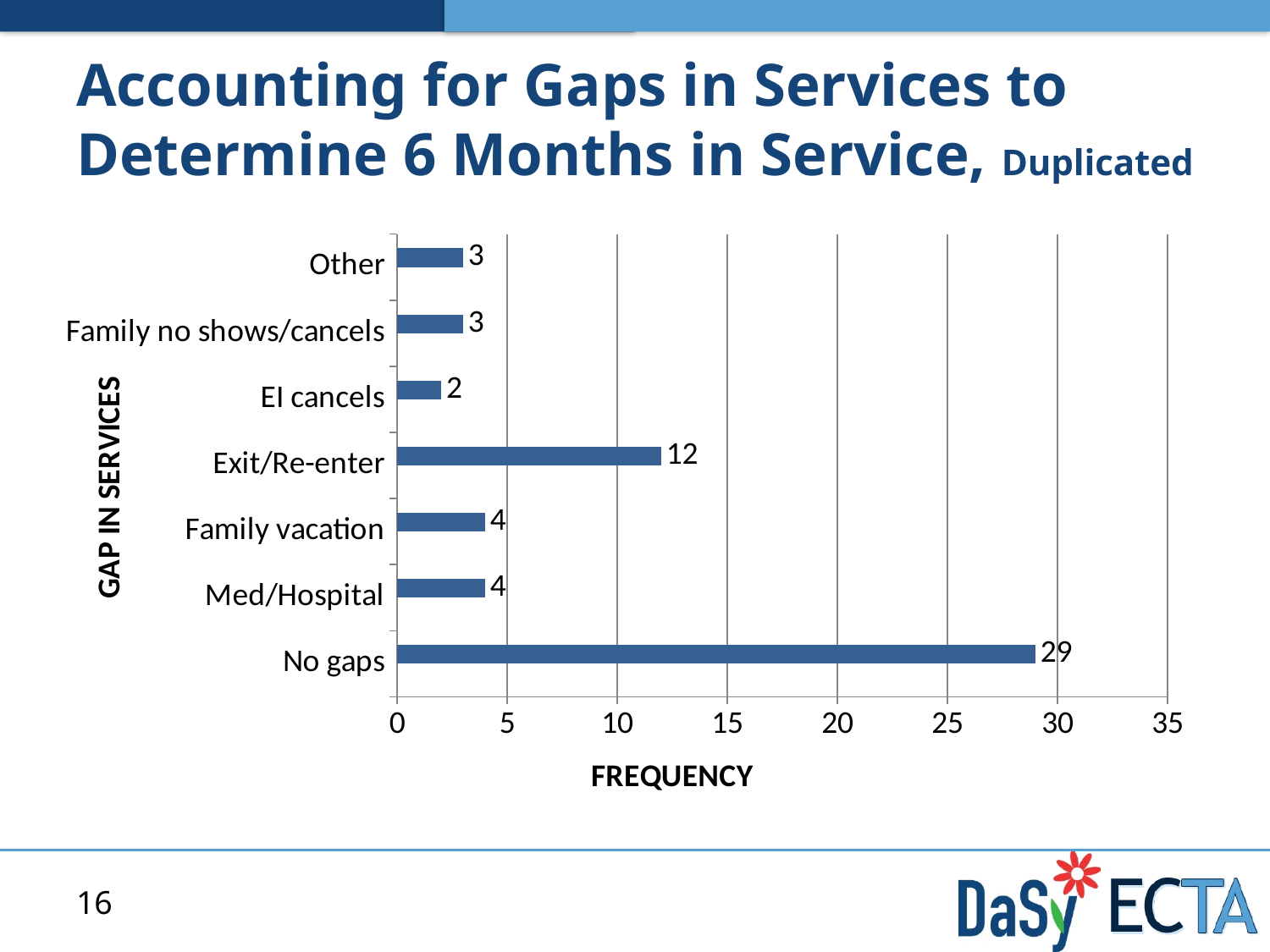
What is the frequency for No gaps? 29 What is the frequency for Exit/Re-enter? 12 What is the label of the horizontal axis of the chart? FREQUENCY What is the difference in frequency between No gaps and Exit/Re-enter? 17 Which gap in services category has the highest frequency? No gaps What is the frequency for EI cancels? 2 What kind of chart is shown on the slide? Bar chart Is the frequency for No gaps greater or less than 25? greater Which gap in services category has the lowest frequency? EI cancels What is the frequency for Family vacation? 4 Which has a higher frequency, Exit/Re-enter or Med/Hospital? Exit/Re-enter How many gap in services categories are shown in the chart? 7